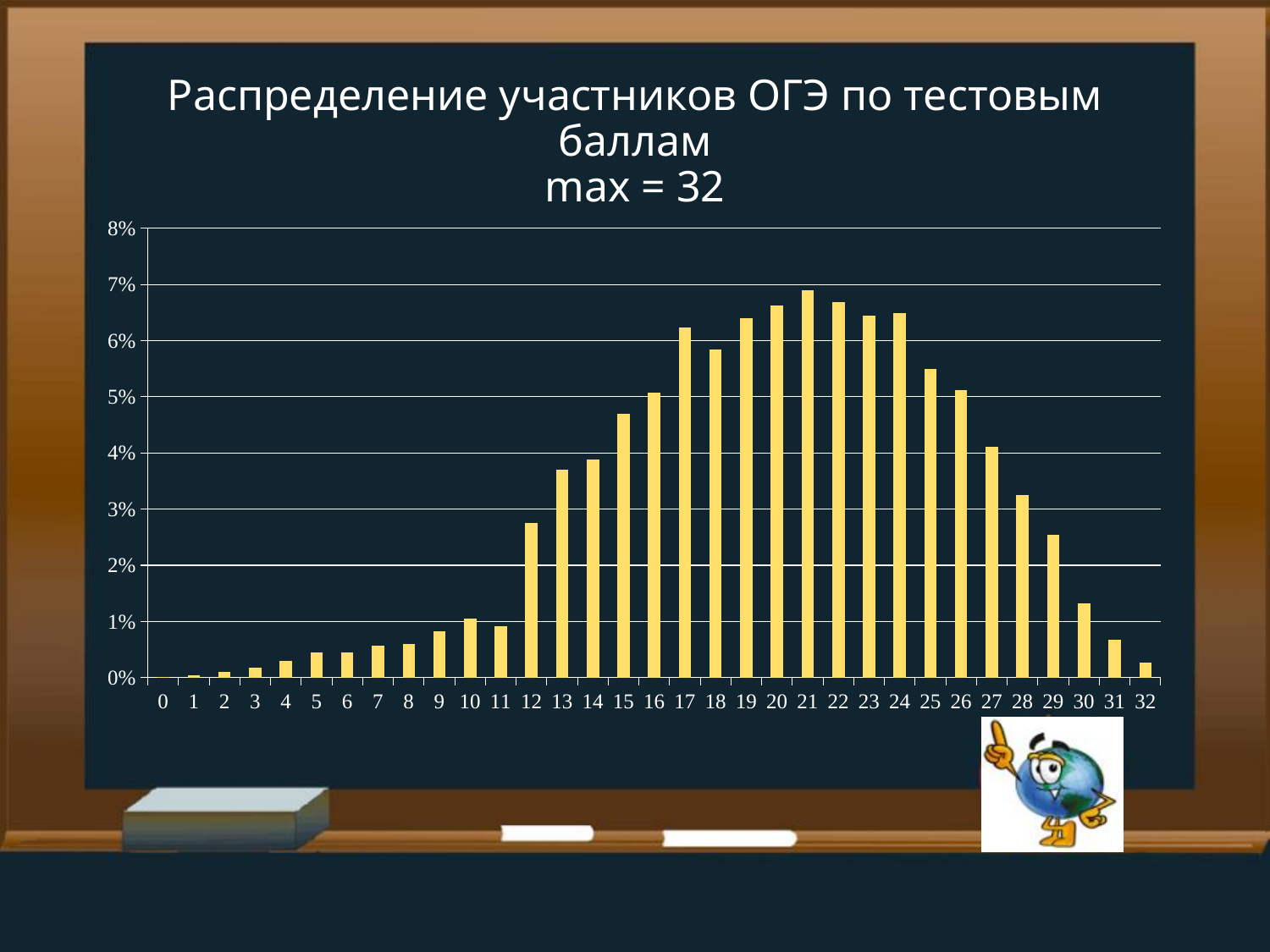
What kind of chart is shown on the slide? bar chart Which has a larger share of participants, score 17 or score 29? 17 Do the values rise or fall along the x axis from score 21 to score 32? fall Is the value for score 12 greater or less than 3%? less What maximum score is stated in the chart title? 32 Is the value for score 15 greater or less than 4%? greater Is the value for score 31 greater or less than 1%? less Which test score has the highest share of participants? 21 How many score categories are shown along the x axis? 33